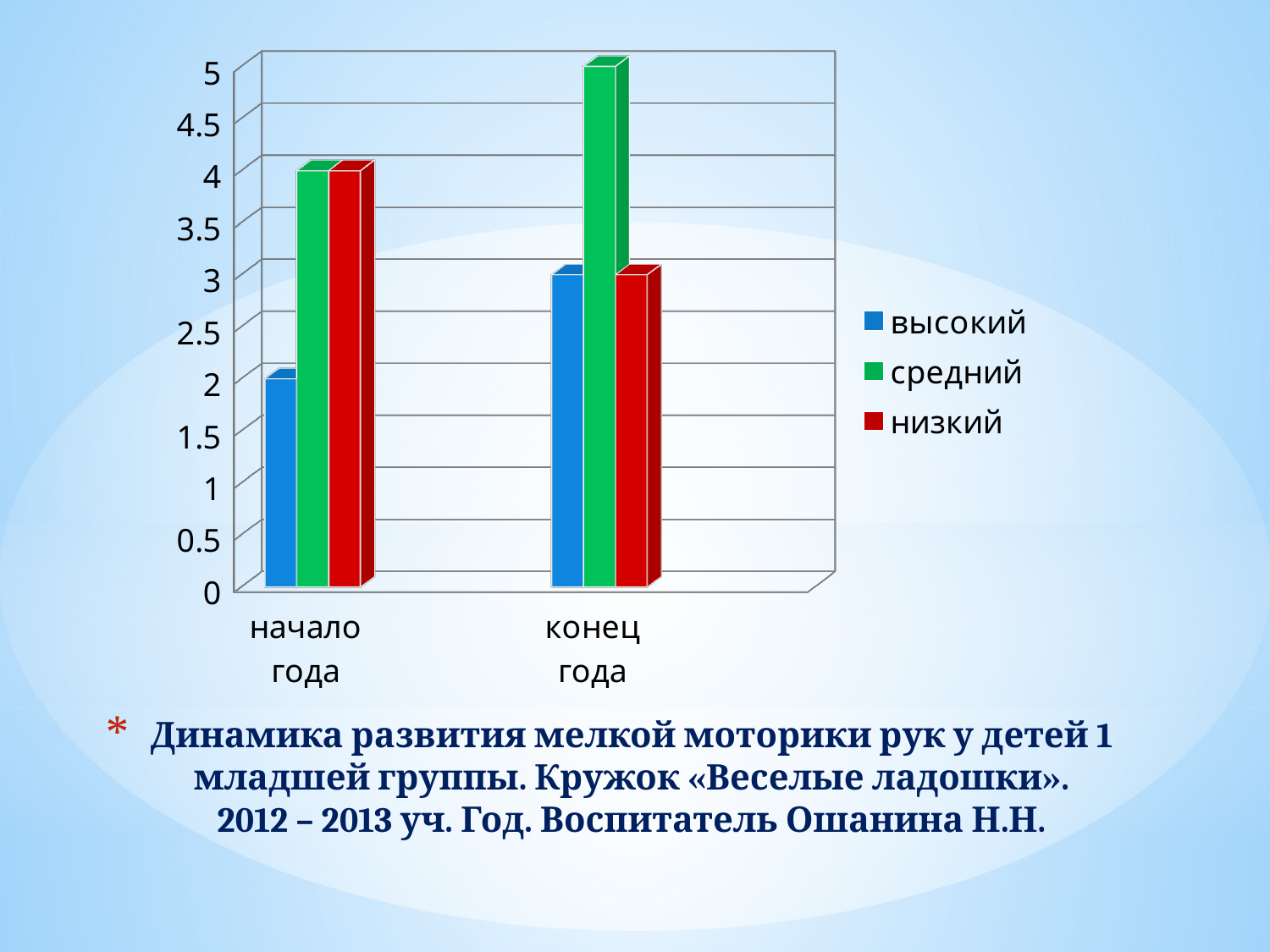
Does the value for низкий rise or fall from начало года to конец года? fall Which series has the highest value at конец года? средний How many categories are shown on the x axis? 2 What is the value for высокий at конец года? 3 What is the difference between the средний values at конец года and начало года? 1 What is the value for средний at конец года? 5 What is the value for высокий at начало года? 2 What is the value for низкий at начало года? 4 What kind of chart is shown on the slide? bar chart How many series does the legend list? 3 Is the value for высокий larger at начало года or at конец года? конец года Which series has the lowest value at начало года? высокий